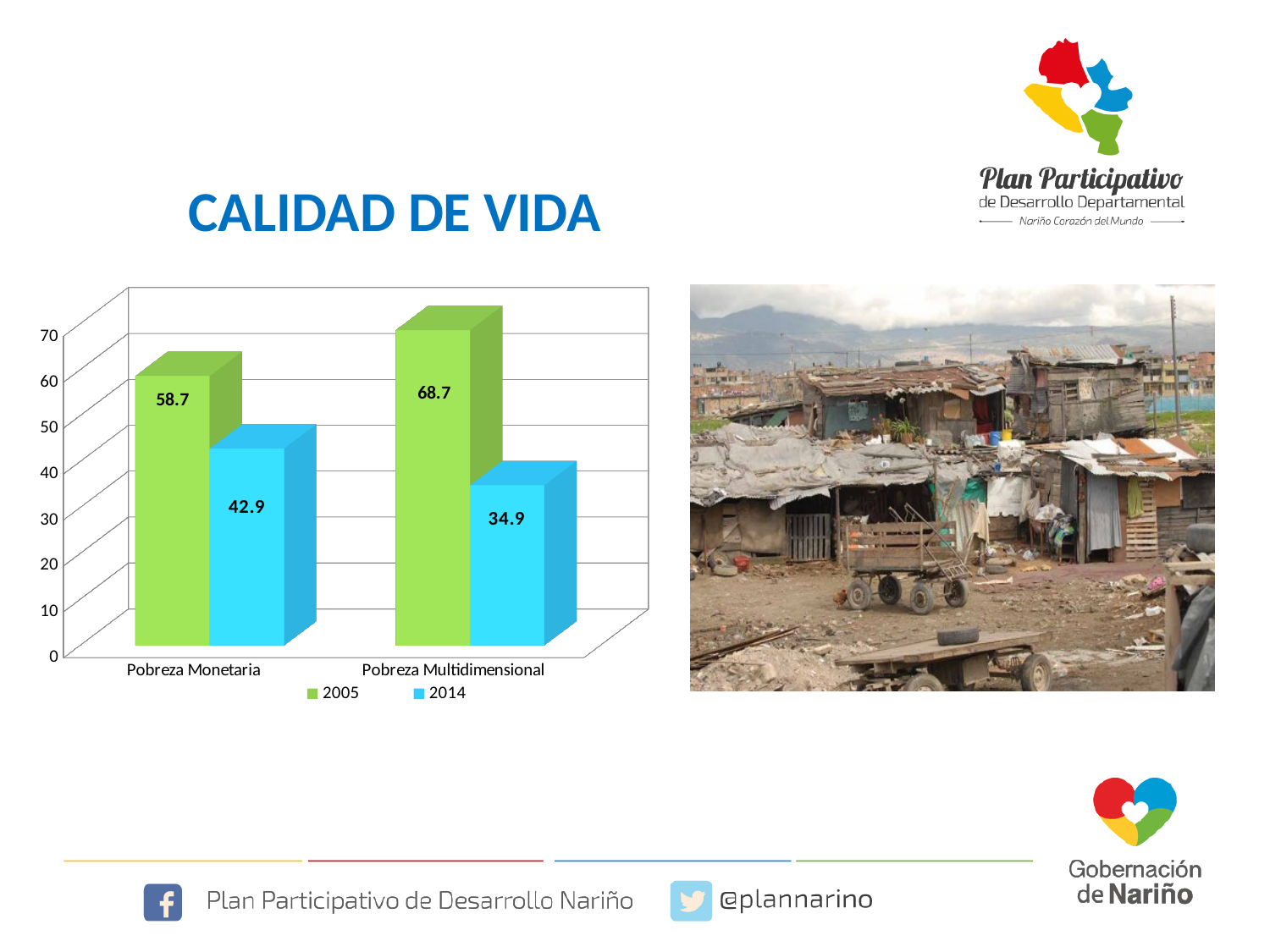
How many series does the chart legend list? 2 What is the difference between the 2005 and 2014 values for Pobreza Monetaria? 15.8 What is the 2014 value for Pobreza Multidimensional? 34.9 How many categories are shown on the x axis of the chart? 2 What is the 2014 value for Pobreza Monetaria? 42.9 What is the difference between the 2005 and 2014 values for Pobreza Multidimensional? 33.8 What is the 2005 value for Pobreza Multidimensional? 68.7 Which is larger: the 2014 value for Pobreza Monetaria or the 2014 value for Pobreza Multidimensional? Pobreza Monetaria What kind of chart is shown on the slide? Bar chart Which category has the highest 2005 value? Pobreza Multidimensional What is the 2005 value for Pobreza Monetaria? 58.7 Which category has the lowest 2014 value? Pobreza Multidimensional